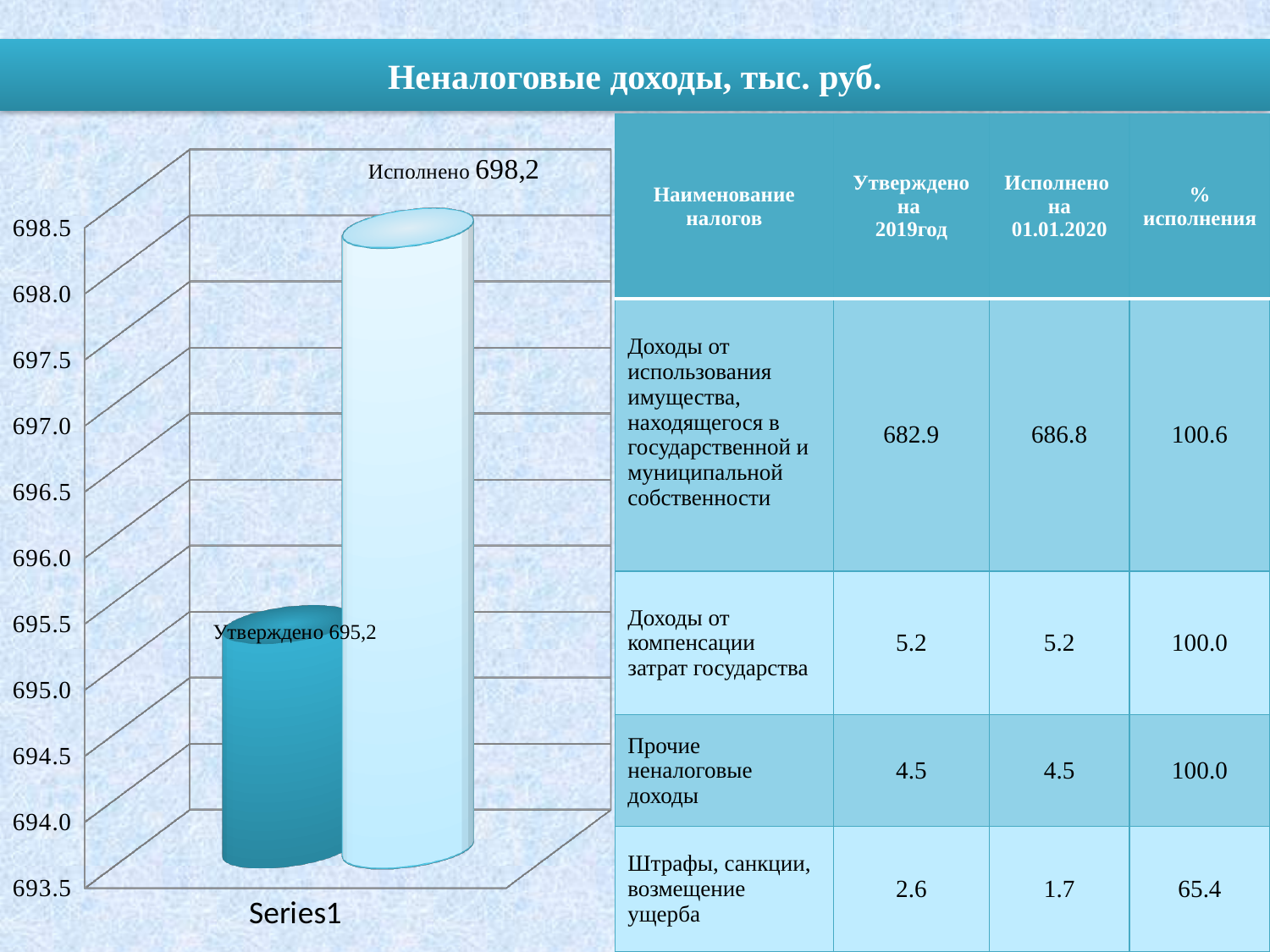
How many bars are plotted in the chart? 2 Is the value for Исполнено in the chart greater or less than 697.0? greater Which is larger in the chart, Утверждено or Исполнено? Исполнено Which bar in the chart is the highest? Исполнено What is the value of the Утверждено bar in the chart? 695,2 What is the value of the Исполнено bar in the chart? 698,2 Which bar in the chart is the lowest? Утверждено What is the difference between the Исполнено and Утверждено values in the chart? 3,0 What is the category label shown under the bars on the x axis of the chart? Series1 What kind of chart is shown on the slide? bar chart What is the title of the slide containing the chart? Неналоговые доходы, тыс. руб. Is the value for Утверждено in the chart greater or less than 696.0? less